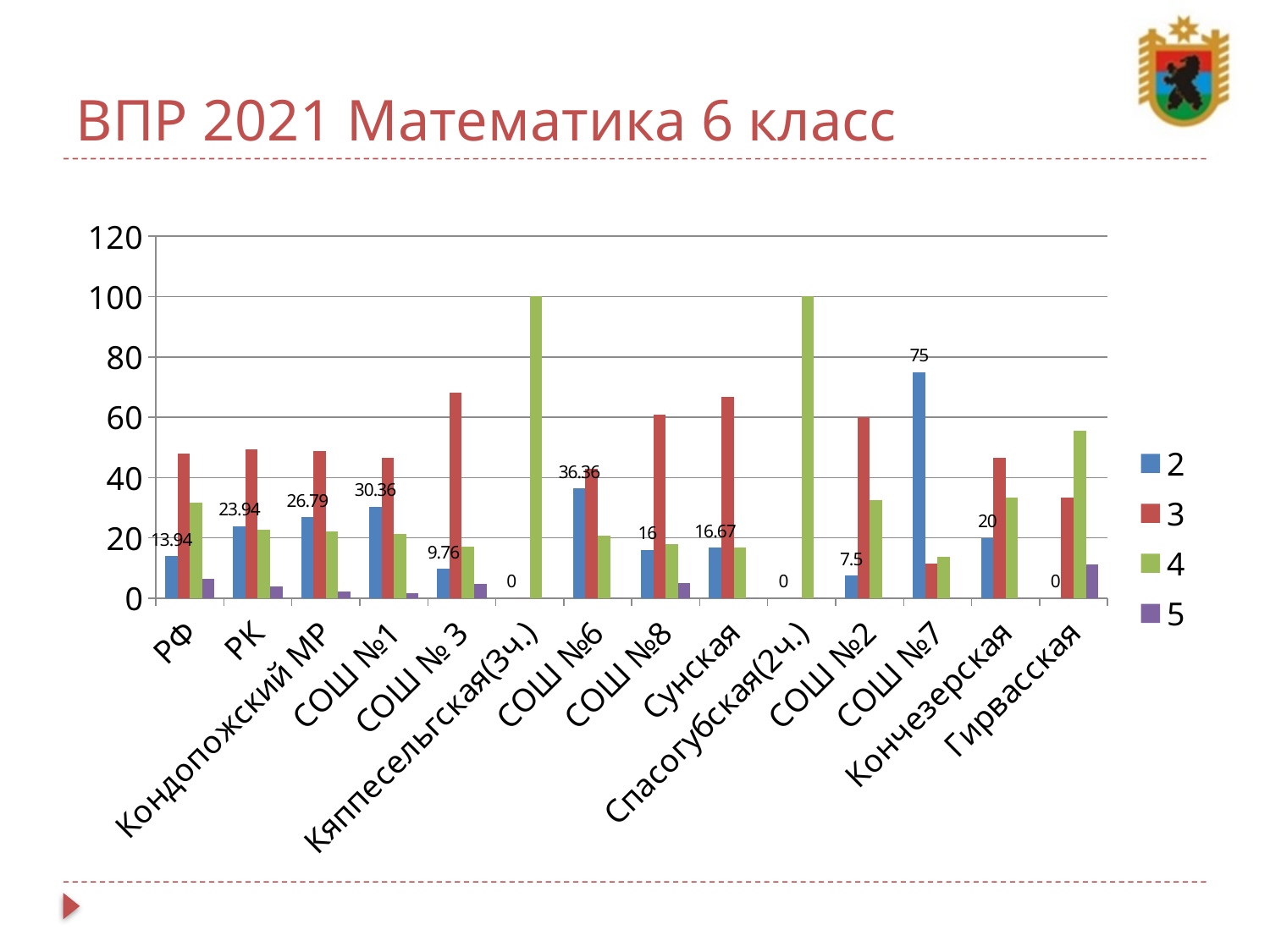
Which has the larger series "2" value, СОШ №1 or СОШ №6? СОШ №6 What is the value of series "2" for Кондопожский МР? 26.79 What is the title of the slide? ВПР 2021 Математика 6 класс Which category has the highest value for series "2"? СОШ №7 How many series does the legend list? 4 How many categories are shown on the x axis? 14 Is the value of series "3" for СОШ № 3 greater or less than 60? greater What is the value of series "2" for Сунская? 16.67 What is the value of series "2" for СОШ №7? 75 Is the value of series "4" for Кяппесельгская(3ч.) greater or less than 80? greater What is the value of series "2" for СОШ № 3? 9.76 What is the difference between the series "2" values for РК and РФ? 10